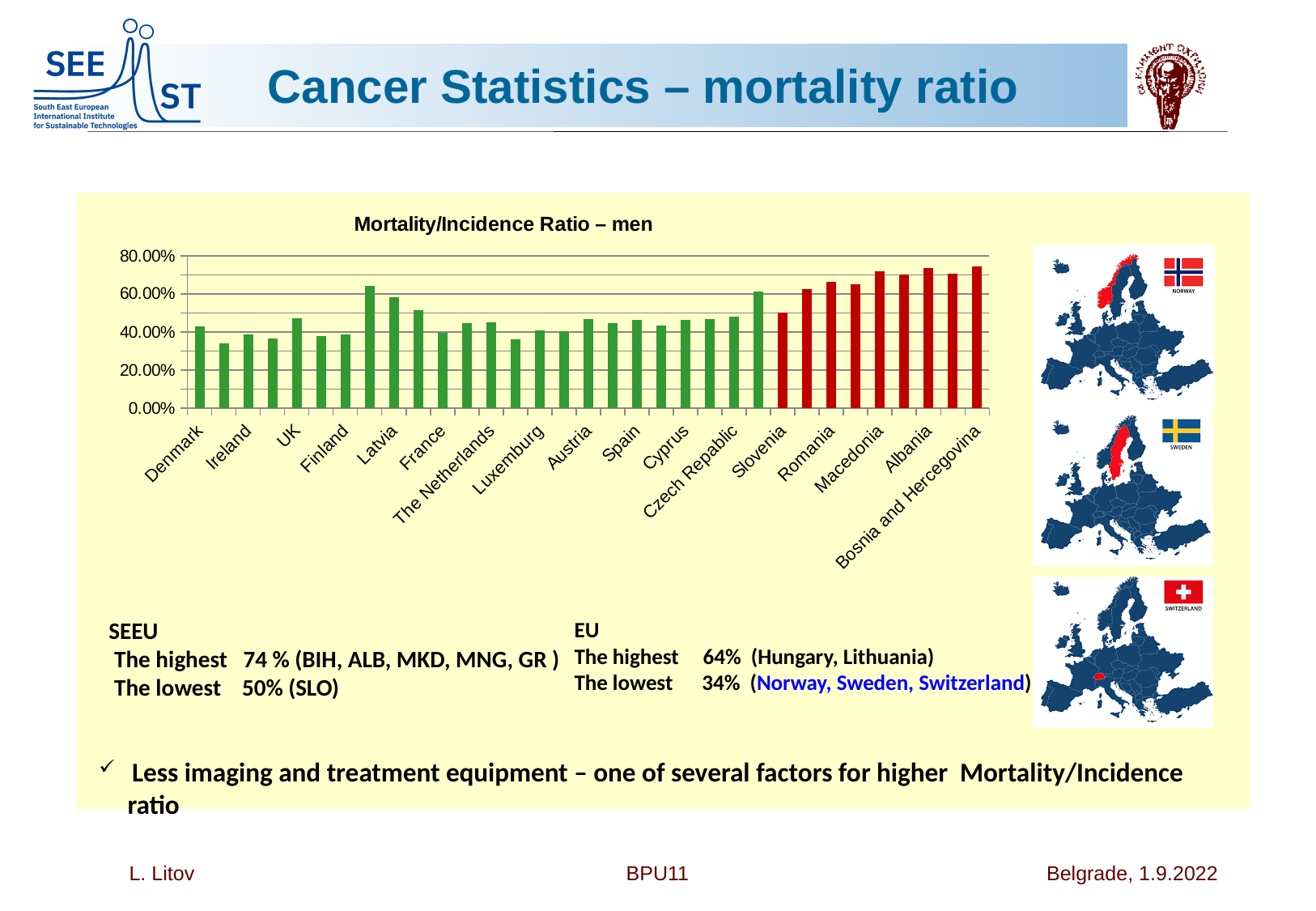
Which has the larger value, Latvia or Denmark? Latvia Is the value for Macedonia greater or less than 60.00%? greater What kind of chart is shown on the slide? bar chart What is the title of the chart? Mortality/Incidence Ratio – men Is the value for Slovenia greater or less than 60.00%? less Which has the larger value, Bosnia and Hercegovina or Spain? Bosnia and Hercegovina Do the values generally rise or fall from left to right along the x axis? rise What two colours are used for the bars in the chart? green and red Is the value for Bosnia and Hercegovina greater or less than 60.00%? greater